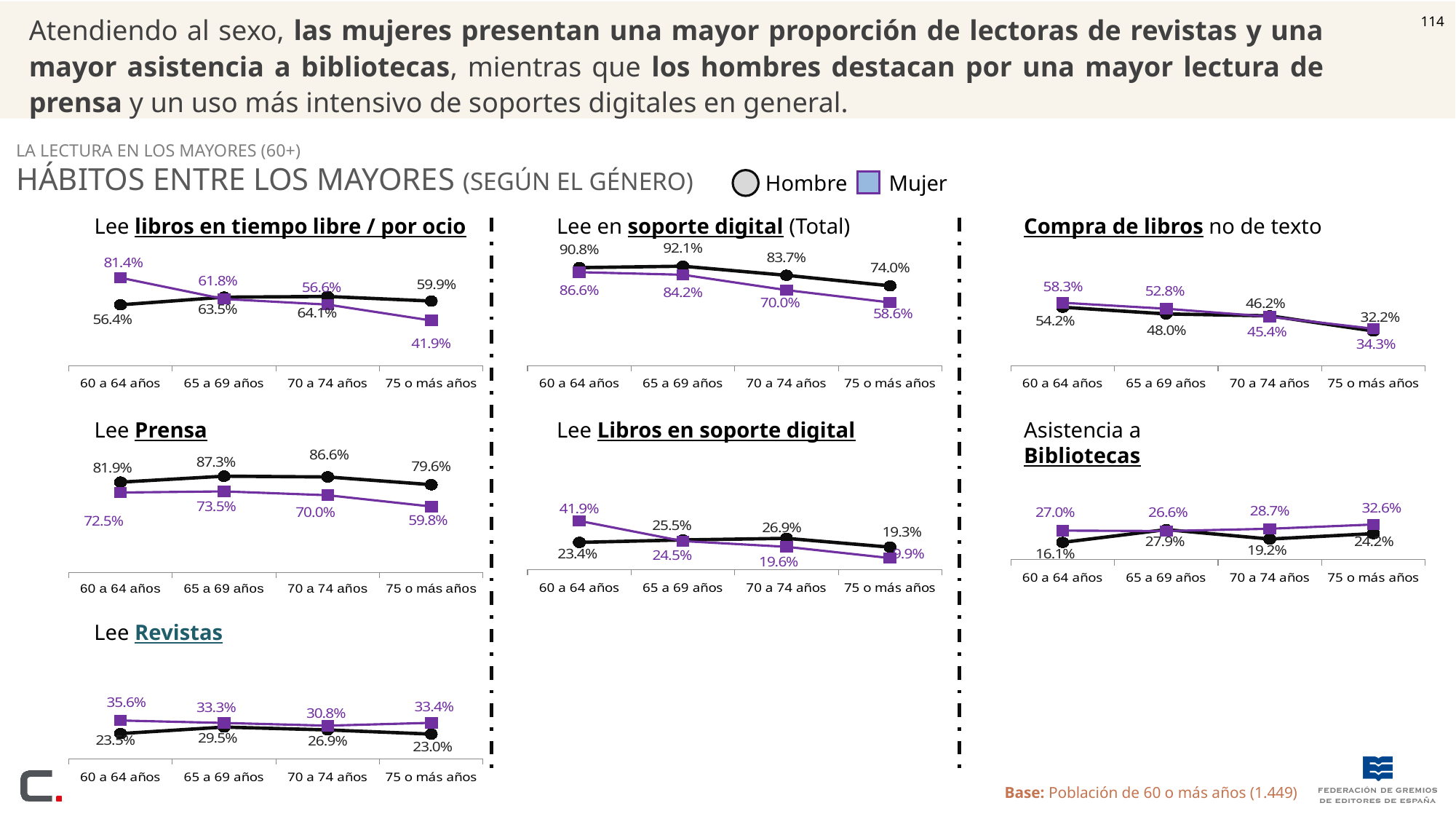
In the 'Lee libros en tiempo libre / por ocio' chart, does the Mujer series rise or fall from 60 a 64 años to 75 o más años? Fall In the 'Lee Prensa' chart, what is the difference between Hombre and Mujer in the 75 o más años group? 19.8 percentage points In the 'Asistencia a Bibliotecas' chart, which is larger in the 60 a 64 años group, Hombre or Mujer? Mujer In the 'Lee en soporte digital (Total)' chart, which age group has the highest value for Hombre? 65 a 69 años Which colour represents the Mujer series in the legend? Purple In the 'Lee en soporte digital (Total)' chart, what is the value for Mujer in the 70 a 74 años group? 70.0% What type of chart is 'Lee Libros en soporte digital'? Line chart In the 'Lee libros en tiempo libre / por ocio' chart, what is the value for Mujer in the 60 a 64 años group? 81.4% How many age groups are shown on the x axis of the 'Lee Revistas' chart? 4 In the 'Compra de libros no de texto' chart, which age group has the lowest value for Mujer? 75 o más años In the 'Lee Prensa' chart, what is the value for Hombre in the 65 a 69 años group? 87.3% How many series does the legend list for the charts on this slide? 2